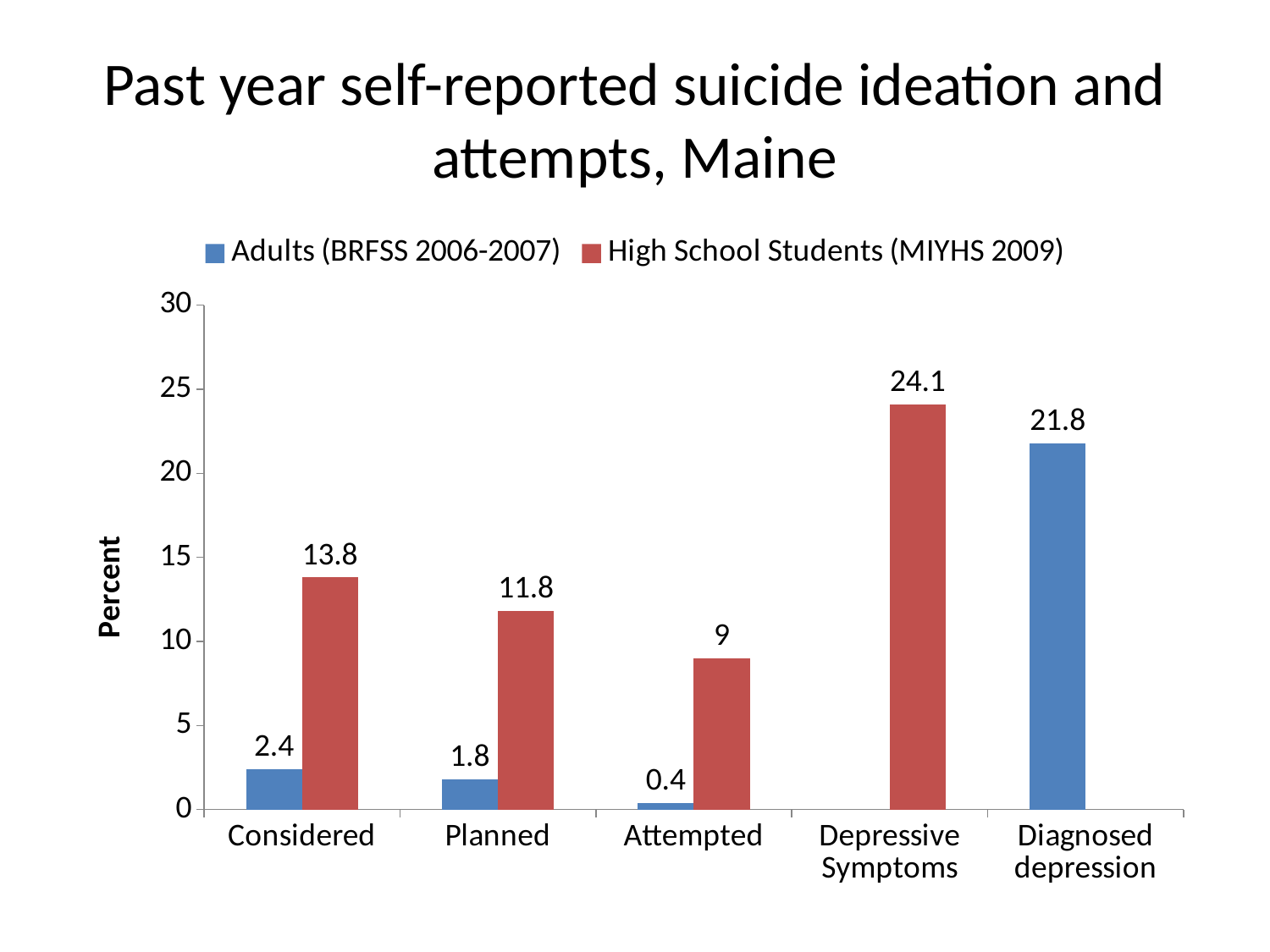
What is the difference between the High School Students and Adults values in the Considered category? 11.4 Which category has the highest value for High School Students (MIYHS 2009)? Depressive Symptoms What is the value for Adults (BRFSS 2006-2007) in the Diagnosed depression category? 21.8 Is the value for High School Students in the Attempted category greater or less than 10? less Which is larger in the Planned category: the Adults value or the High School Students value? High School Students (MIYHS 2009) What is the value for High School Students (MIYHS 2009) in the Planned category? 11.8 How many series does the legend list? 2 What kind of chart is shown on the slide? bar chart What is the value for Adults (BRFSS 2006-2007) in the Attempted category? 0.4 How many categories are shown on the x axis? 5 Which category has the lowest value for Adults (BRFSS 2006-2007)? Attempted What is the value for High School Students (MIYHS 2009) in the Considered category? 13.8